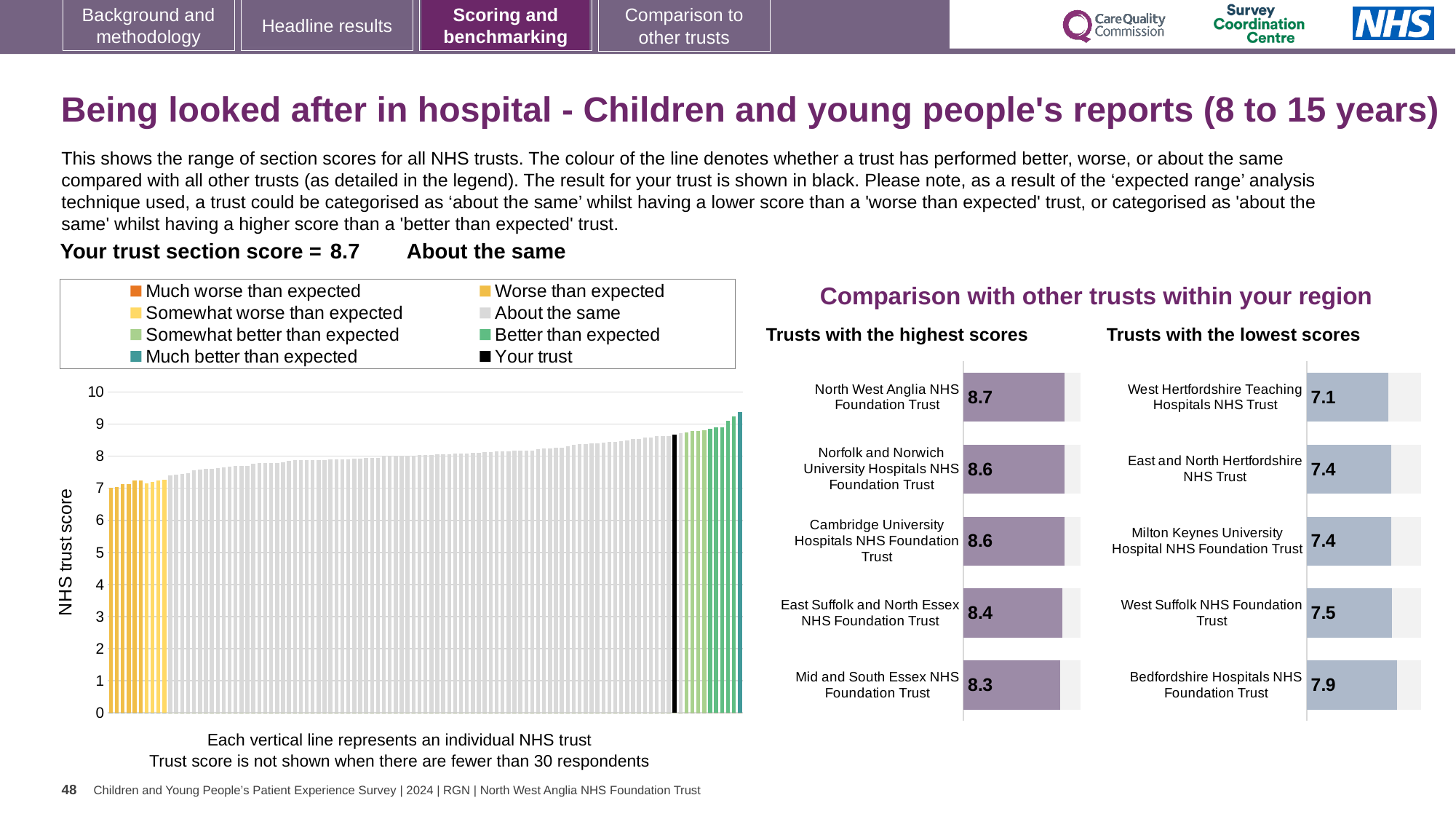
How many trusts are shown in the 'Trusts with the highest scores' chart? 5 In the 'Trusts with the lowest scores' chart, which has the higher score: West Suffolk NHS Foundation Trust or Bedfordshire Hospitals NHS Foundation Trust? Bedfordshire Hospitals NHS Foundation Trust In the 'Trusts with the highest scores' chart, what is the score for North West Anglia NHS Foundation Trust? 8.7 In the 'Trusts with the lowest scores' chart, what is the score for West Hertfordshire Teaching Hospitals NHS Trust? 7.1 In the 'Trusts with the highest scores' chart, which trust has the highest score? North West Anglia NHS Foundation Trust In the large 'NHS trust score' chart on the left, do the values rise or fall from left to right? rise In the large 'NHS trust score' chart on the left, is the value of the black bar (your trust) greater or less than 8? greater What kind of chart is the large 'NHS trust score' chart on the left of the slide? bar chart In the 'Trusts with the lowest scores' chart, what is the difference between the scores of Bedfordshire Hospitals NHS Foundation Trust and West Hertfordshire Teaching Hospitals NHS Trust? 0.8 In the 'Trusts with the highest scores' chart, what is the difference between the scores of North West Anglia NHS Foundation Trust and Mid and South Essex NHS Foundation Trust? 0.4 How many entries does the legend above the large 'NHS trust score' chart list? 8 In the 'Trusts with the lowest scores' chart, which trust has the lowest score? West Hertfordshire Teaching Hospitals NHS Trust